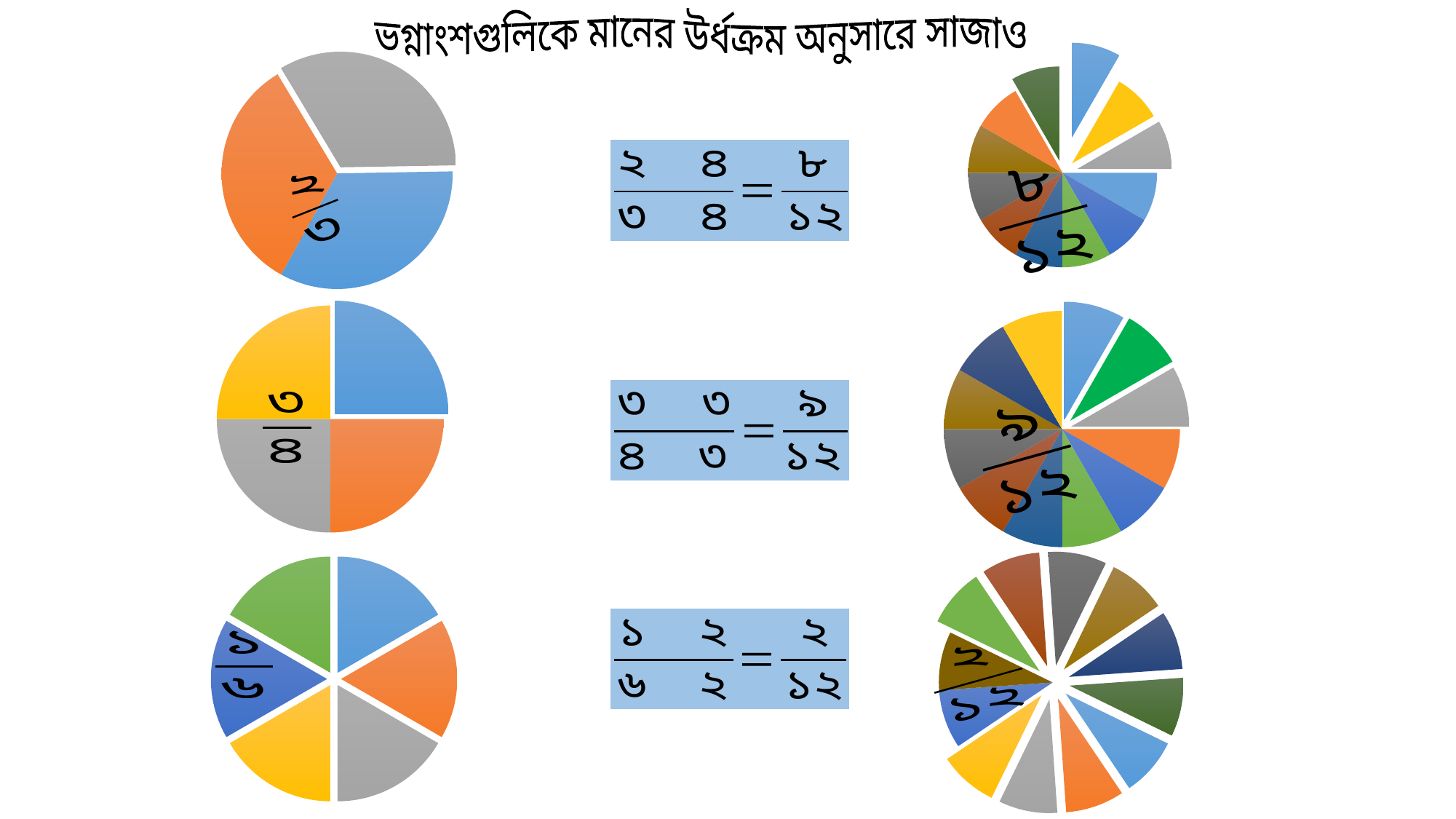
What fraction is written on the top-left pie chart? ২/৩ How many slices does the top-left pie chart have? 3 What fraction is written on the bottom-left pie chart? ১/৬ How many slices does the middle-right pie chart have? 12 How many slices does the bottom-left pie chart have? 6 What kind of chart is the top-left chart on the slide? pie chart What fraction is written on the middle-left pie chart? ৩/৪ How many pie charts are shown on the slide in total? 6 What fraction is written on the middle-right pie chart? ৯/১২